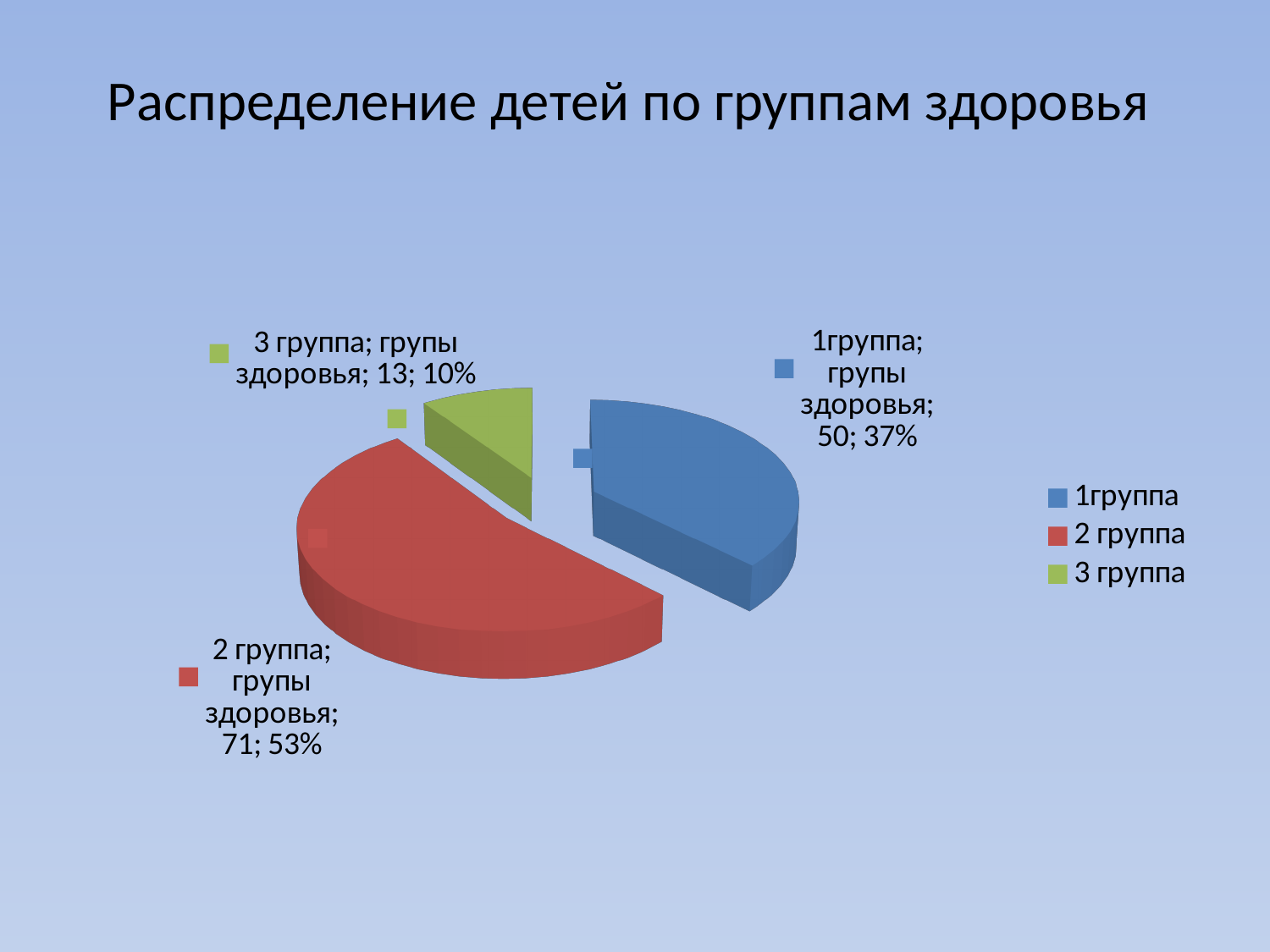
What is the value for 3 группа? 13 Which group has the largest slice? 2 группа What share of the pie does 1группа take? 37% What kind of chart is shown on the slide? pie chart How many slices does the pie chart have? 3 Which is larger, the value for 1группа or 3 группа? 1группа What is the difference between the values for 2 группа and 1группа? 21 What share of the pie does 2 группа take? 53% What is the value for 2 группа? 71 What is the value for 1группа? 50 What share of the pie does 3 группа take? 10% Which group has the smallest slice? 3 группа